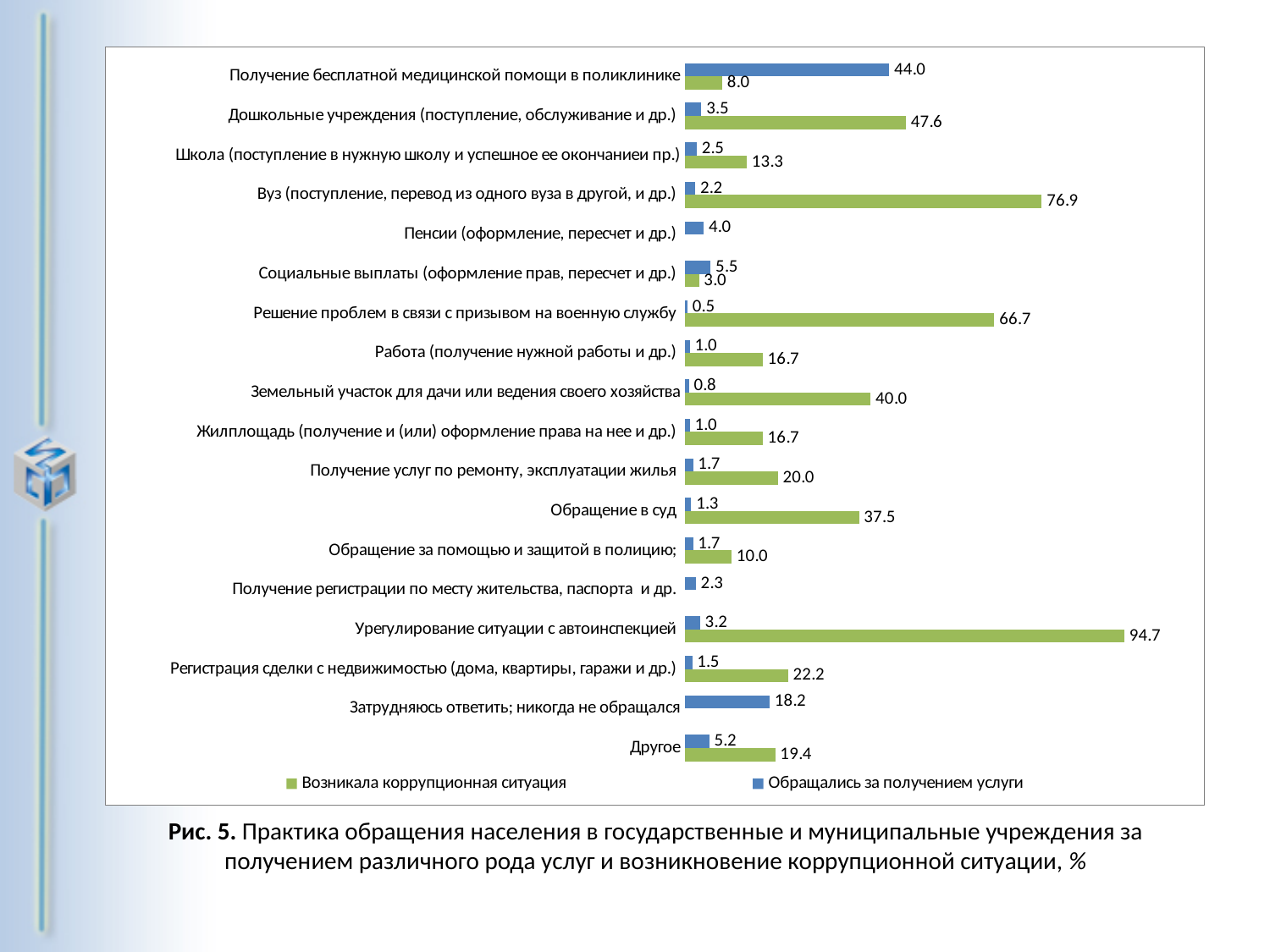
Which category has the highest value for "Возникала коррупционная ситуация"? Урегулирование ситуации с автоинспекцией Which is larger for "Дошкольные учреждения (поступление, обслуживание и др.)": "Возникала коррупционная ситуация" or "Обращались за получением услуги"? Возникала коррупционная ситуация What is the value of "Возникала коррупционная ситуация" for "Урегулирование ситуации с автоинспекцией"? 94.7 What is the value of "Обращались за получением услуги" for "Затрудняюсь ответить; никогда не обращался"? 18.2 Which category has the lowest value for "Обращались за получением услуги"? Решение проблем в связи с призывом на военную службу What is the difference between the "Возникала коррупционная ситуация" values for "Урегулирование ситуации с автоинспекцией" and "Вуз (поступление, перевод из одного вуза в другой, и др.)"? 17.8 How many categories are shown on the chart? 18 Which colour represents the series "Возникала коррупционная ситуация"? green What is the value of "Возникала коррупционная ситуация" for "Вуз (поступление, перевод из одного вуза в другой, и др.)"? 76.9 What is the value of "Обращались за получением услуги" for "Получение бесплатной медицинской помощи в поликлинике"? 44.0 How many series does the legend list? 2 What type of chart is shown on the slide? bar chart